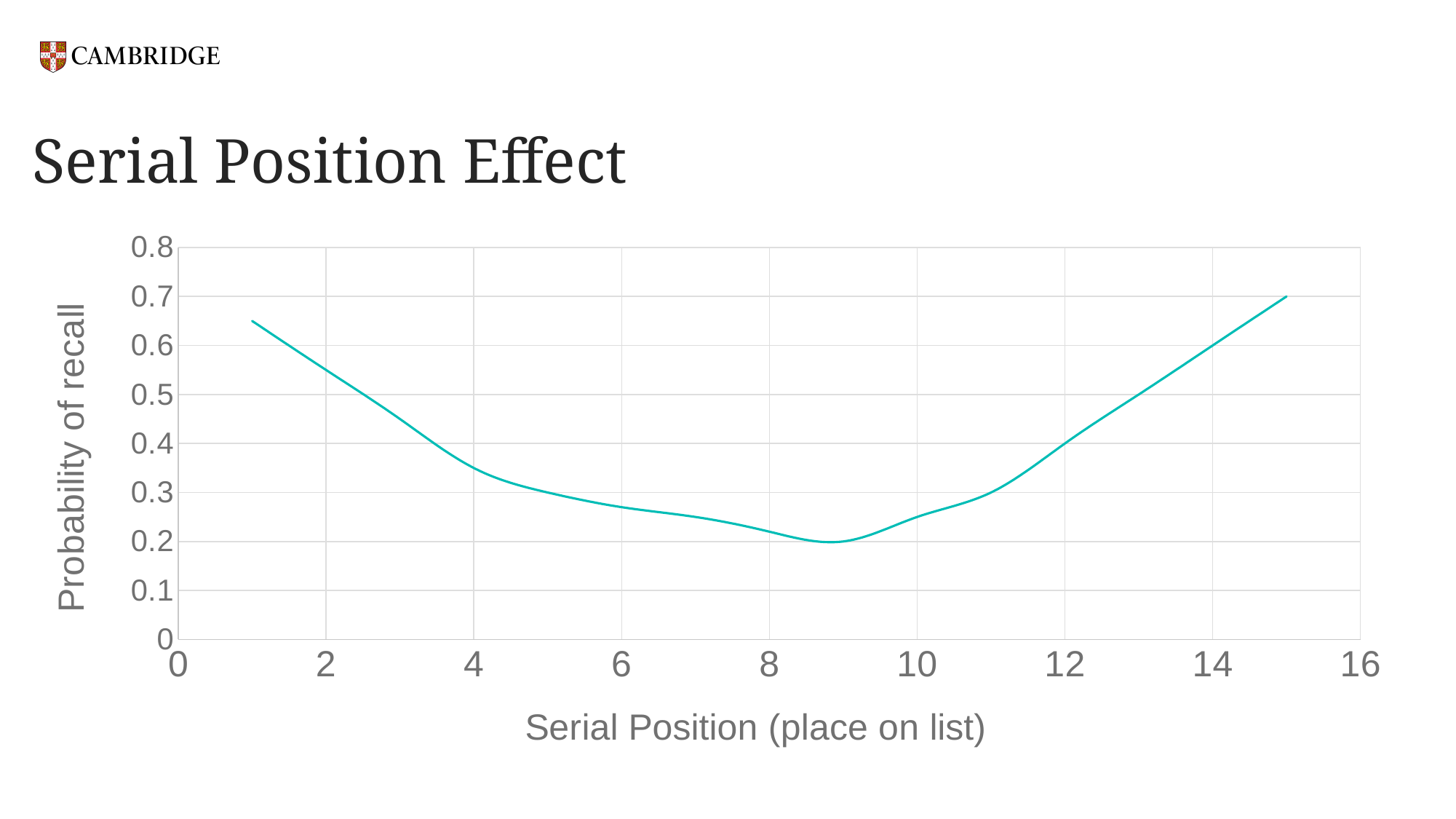
Which serial position has a higher probability of recall, position 3 or position 11? position 3 Is the probability of recall at serial position 15 greater or less than 0.5? greater What is the title of the chart on the slide? Serial Position Effect Is the probability of recall at serial position 5 greater or less than 0.4? less Does the probability of recall rise or fall as serial position increases from 1 to 8? fall Is the probability of recall at serial position 9 greater or less than 0.3? less Does the probability of recall rise or fall as serial position increases from 10 to 15? rise What type of chart is shown on the slide? line chart What is the label of the y axis? Probability of recall Which serial position has a higher probability of recall, position 7 or position 14? position 14